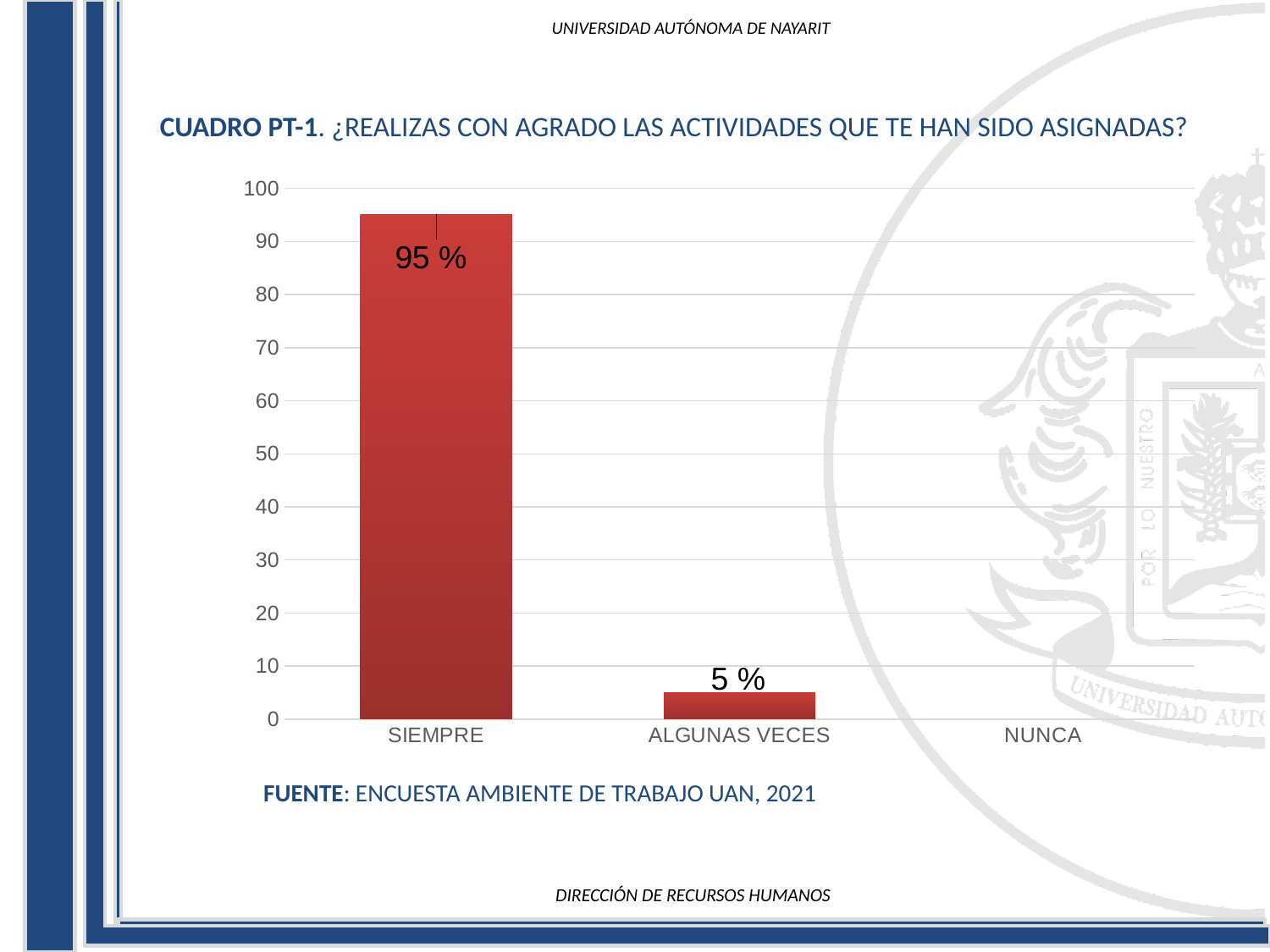
What is the label of the third category on the x axis? NUNCA Which is larger, the value for SIEMPRE or the value for ALGUNAS VECES? SIEMPRE What kind of chart is shown on the slide? bar chart Which category has the highest value? SIEMPRE What is the source cited below the chart? ENCUESTA AMBIENTE DE TRABAJO UAN, 2021 How many categories are shown on the x axis? 3 Is the value for SIEMPRE greater or less than 90? greater What is the value for SIEMPRE? 95 % Is the value for ALGUNAS VECES greater or less than 10? less What is the difference between the values for SIEMPRE and ALGUNAS VECES? 90 % Do the values rise or fall from SIEMPRE to ALGUNAS VECES? fall What is the value for ALGUNAS VECES? 5 %